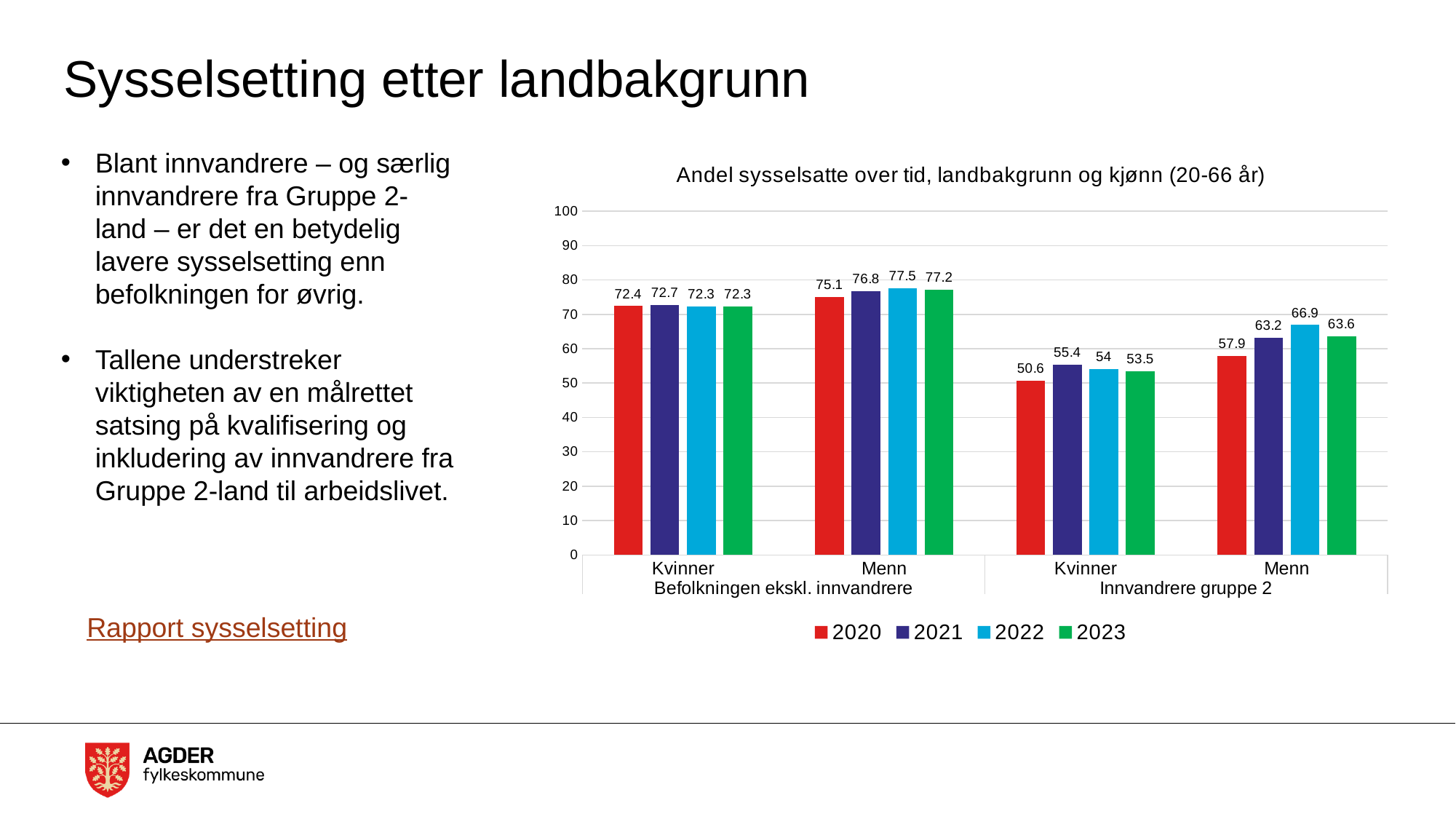
What is the difference between the 2023 values for Menn in Befolkningen ekskl. innvandrere and Menn in Innvandrere gruppe 2? 13.6 What is the title of the chart? Andel sysselsatte over tid, landbakgrunn og kjønn (20-66 år) How many series does the legend list? 4 How many category groups are shown on the x axis? 4 What is the value for Menn in Innvandrere gruppe 2 for 2022? 66.9 What is the value for Kvinner in Befolkningen ekskl. innvandrere for 2020? 72.4 Is the 2020 value for Menn in Innvandrere gruppe 2 greater or less than 60? less What is the value for Kvinner in Innvandrere gruppe 2 for 2023? 53.5 What kind of chart is shown on the slide? Bar chart Which group and year has the lowest value in the chart? Kvinner, Innvandrere gruppe 2, 2020 Which year has the highest value for Menn in Befolkningen ekskl. innvandrere? 2022 Which is larger: the 2021 value for Kvinner in Innvandrere gruppe 2 or the 2021 value for Menn in Innvandrere gruppe 2? Menn in Innvandrere gruppe 2